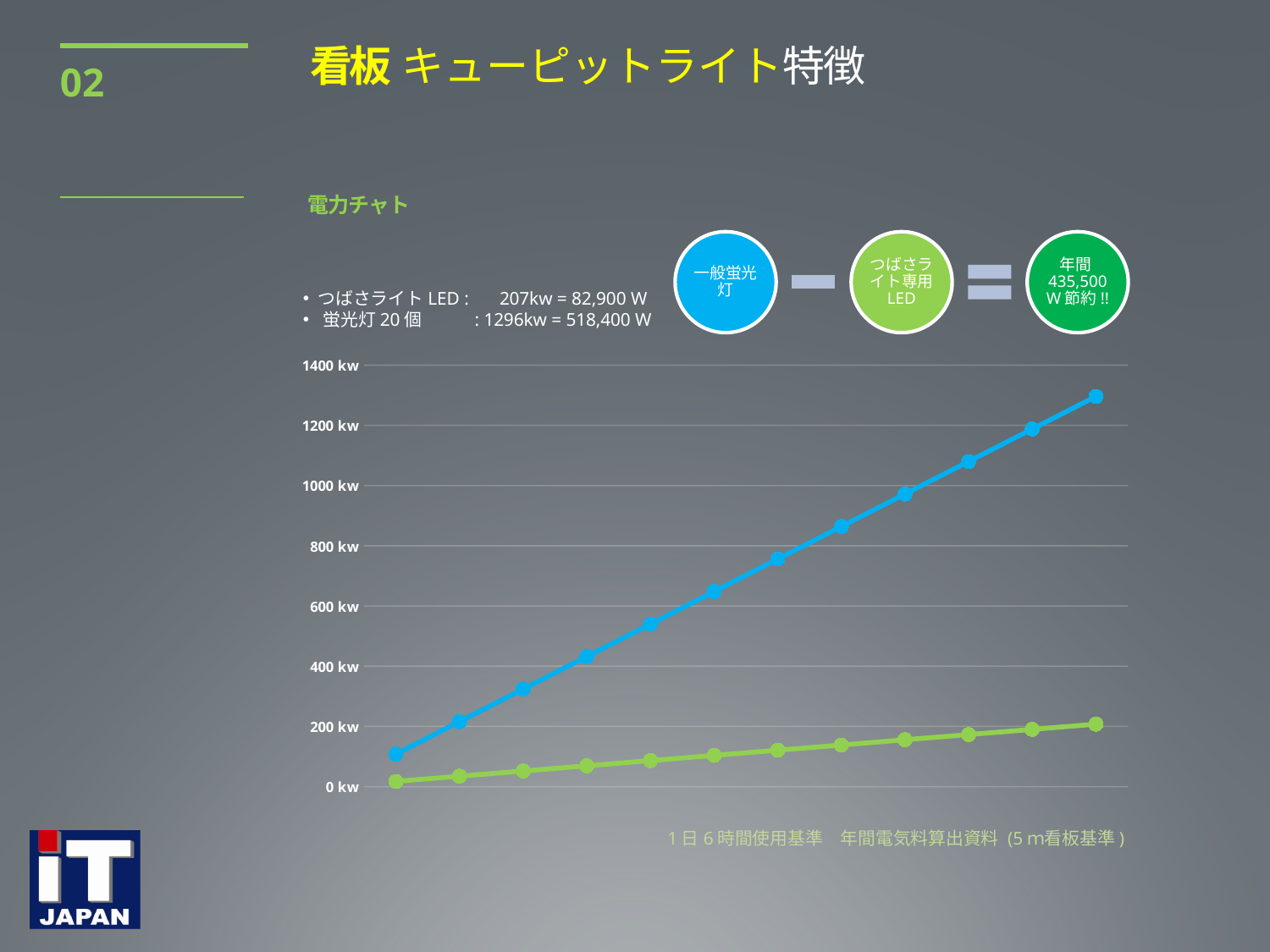
How many lines are plotted on the chart? 2 How many data points does the blue line have? 12 What kind of chart is shown on the slide? line chart Do the values of the green line rise or fall from left to right? rise Is the first (leftmost) point of the green line greater or less than 200 kw? less How many data points does the green line have? 12 Is the last (rightmost) point of the blue line greater or less than 1200 kw? greater At the rightmost point, which line has the higher value, the blue line or the green line? the blue line Is the first (leftmost) point of the blue line greater or less than 200 kw? less Do the values of the blue line rise or fall from left to right? rise What is the title written above the chart? 電力チャト What is the highest value shown on the vertical axis of the chart? 1400 kw